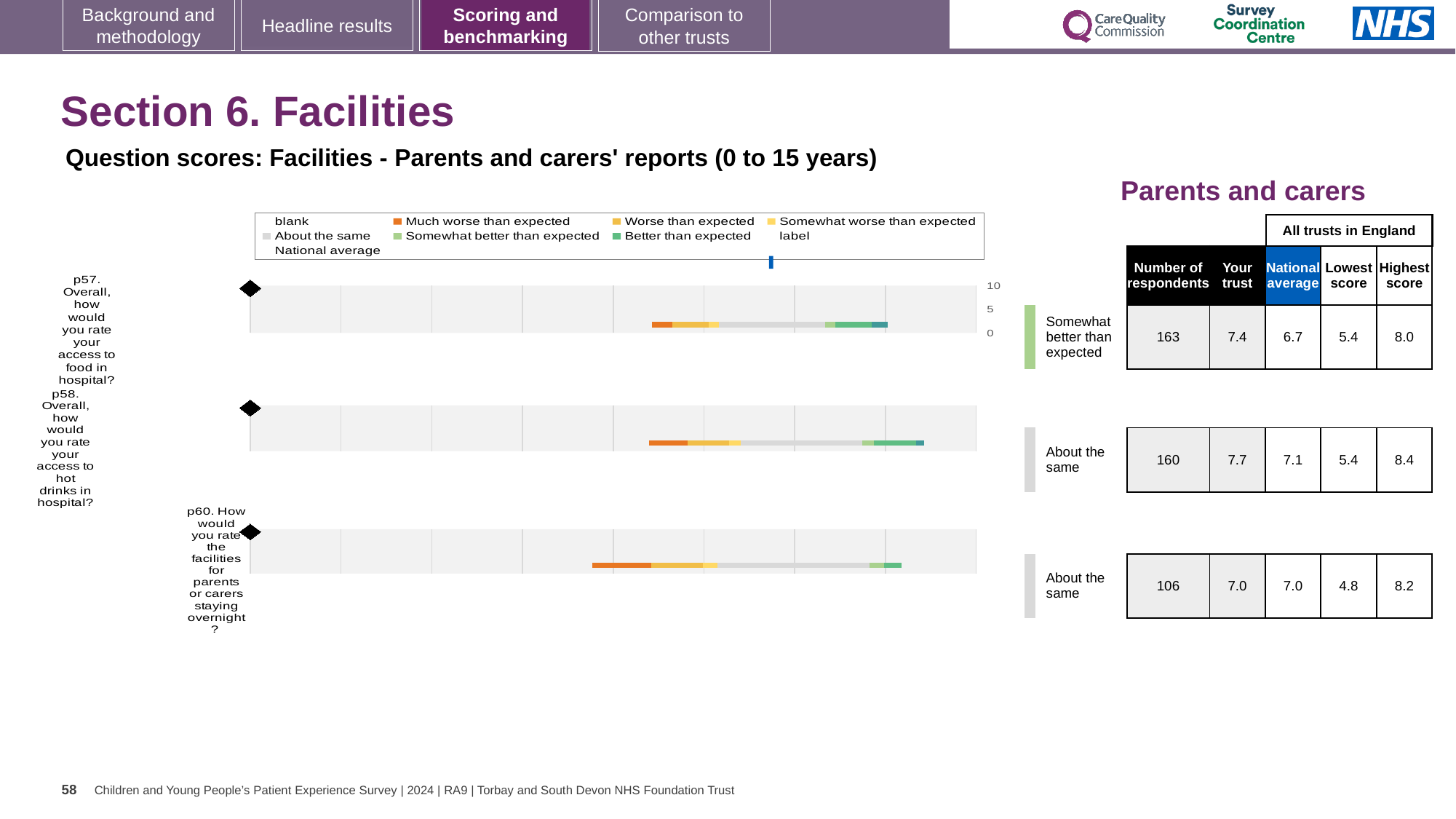
What is the lowest score among all trusts in England for p60? 4.8 Which question has the highest 'Your trust' score? p58 (access to hot drinks in hospital) What benchmark category is shown for p57 (access to food in hospital)? Somewhat better than expected What is the highest score among all trusts in England for p58? 8.4 Is the 'Your trust' score for p57 higher or lower than the 'Your trust' score for p60? higher How many survey questions are plotted in the benchmark charts on this slide? 3 What is the national average score for p58 (access to hot drinks in hospital)? 7.1 What is the difference between the 'Your trust' score and the national average for p57? 0.7 What is the 'Your trust' score for p57 (access to food in hospital)? 7.4 How many respondents answered p60 (facilities for parents or carers staying overnight)? 106 What kind of chart is used to show the benchmark results for each question? bar chart Which question has the lowest number of respondents? p60 (facilities for parents or carers staying overnight)